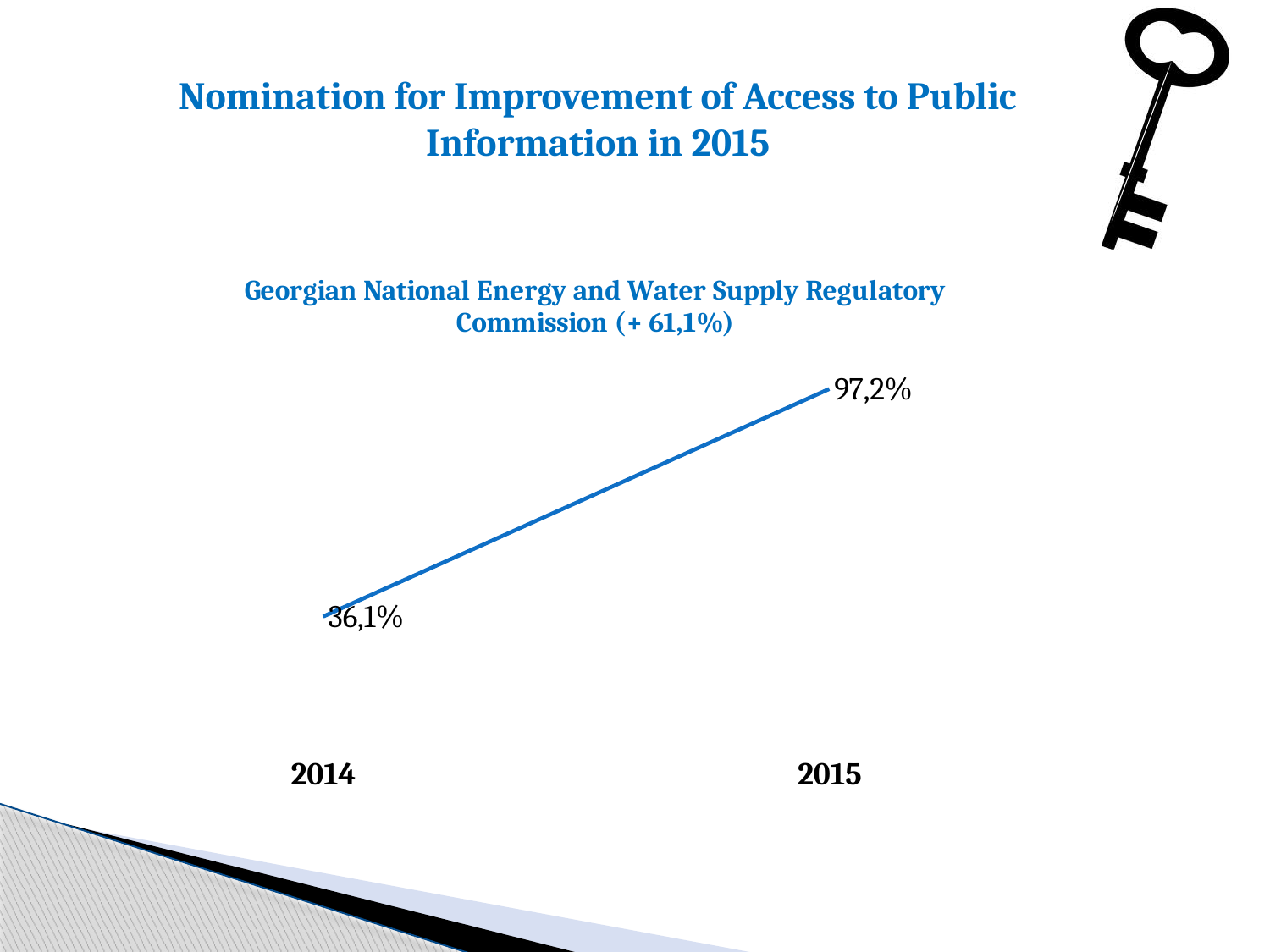
What is the value for 2014? 36,1% What is the value for 2015? 97,2% Which is larger, the value for 2014 or the value for 2015? 2015 How many data points are plotted on the chart? 2 Do the values rise or fall from 2014 to 2015? Rise What colour is the line on the chart? Blue What is the difference between the 2015 value and the 2014 value? 61,1% What is the title of the chart? Georgian National Energy and Water Supply Regulatory Commission (+ 61,1%) Which year has the lowest value? 2014 What kind of chart is shown on the slide? Line chart Which year has the highest value? 2015